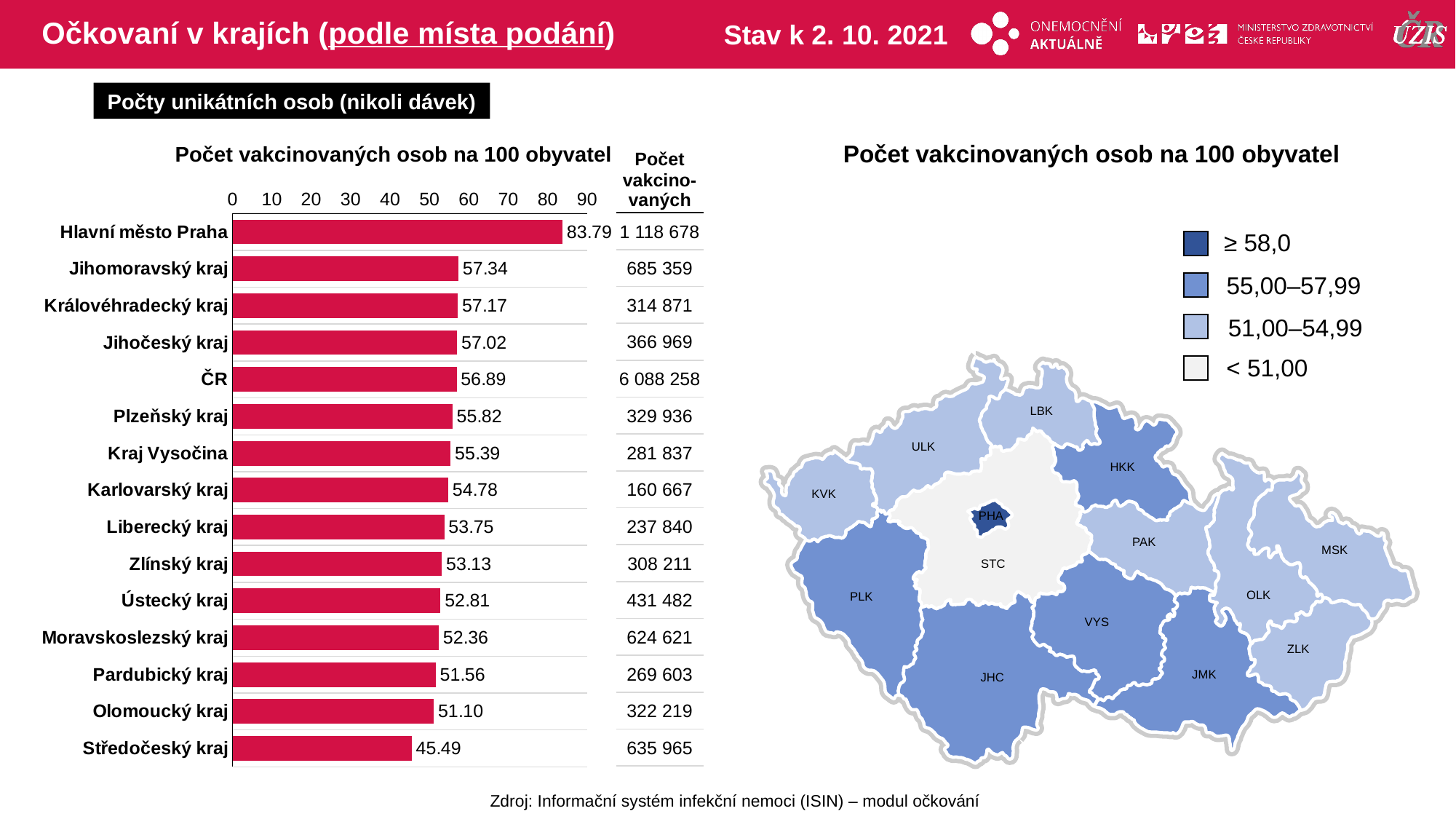
In the bar chart, what is the difference between the values for Hlavní město Praha and Středočeský kraj? 38.30 In the bar chart, what is the value for Středočeský kraj? 45.49 In the bar chart, which is larger, the value for Plzeňský kraj or Kraj Vysočina? Plzeňský kraj In the bar chart, which category has the lowest value? Středočeský kraj In the bar chart, which category has the highest value? Hlavní město Praha In the bar chart, what is the value for ČR? 56.89 In the bar chart, do the values rise or fall going from the top bar to the bottom bar? fall How many categories (bars) does the bar chart show? 15 What kind of chart is shown on the left of the slide? bar chart In the bar chart, is the value for Hlavní město Praha greater or less than 80? greater How many value classes does the legend of the map on the right list? 4 In the bar chart, what is the value for Hlavní město Praha? 83.79